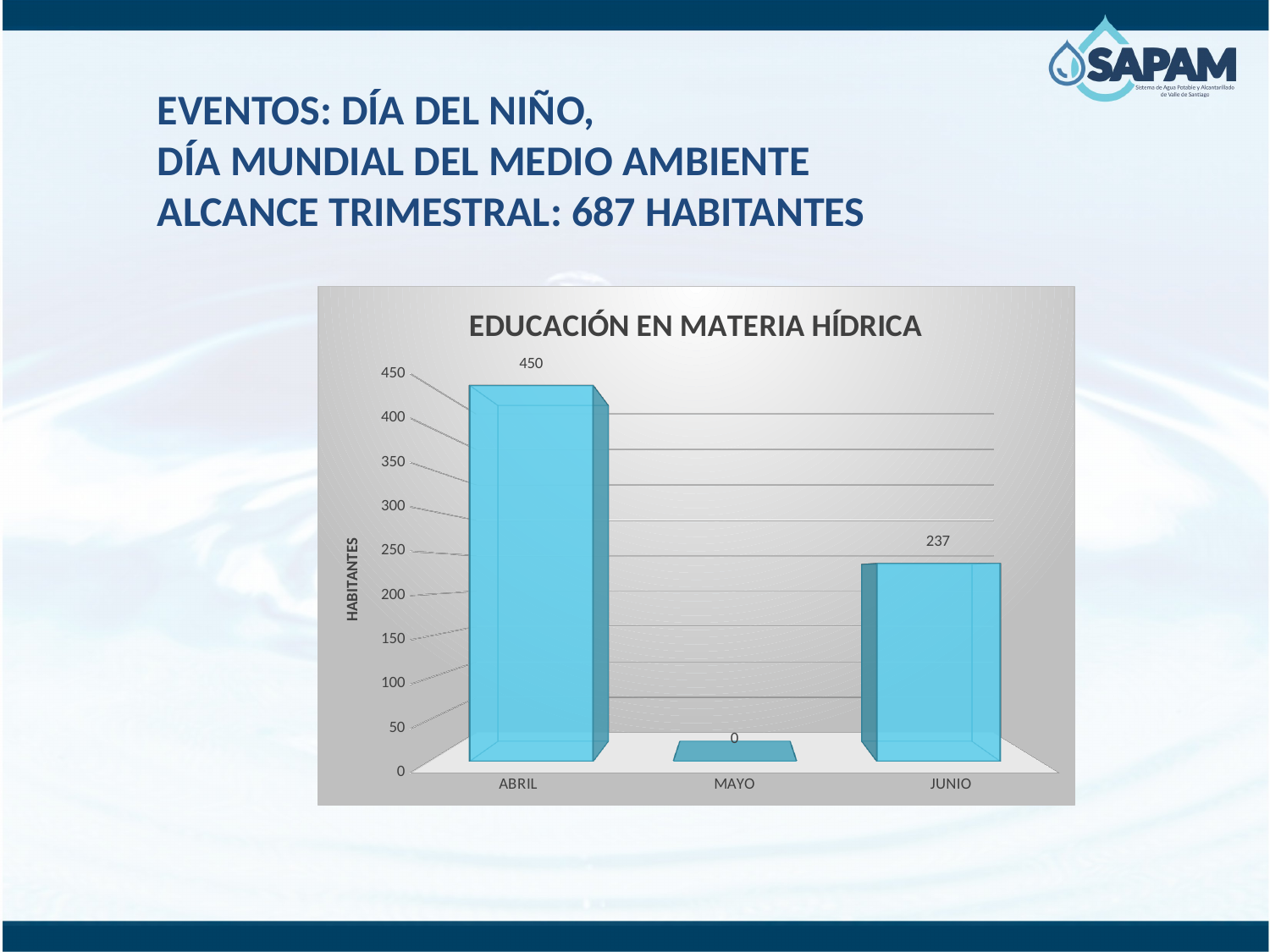
What is the label of the vertical axis? HABITANTES What is the value for MAYO? 0 Which month has the highest value? ABRIL Is the value for JUNIO greater or less than 250? less Which is larger, the value for JUNIO or the value for MAYO? JUNIO What is the value for JUNIO? 237 What is the title of the chart? EDUCACIÓN EN MATERIA HÍDRICA What is the value for ABRIL? 450 What kind of chart is shown? bar chart Which month has the lowest value? MAYO How many months are shown on the x axis? 3 What is the difference between the values for ABRIL and JUNIO? 213